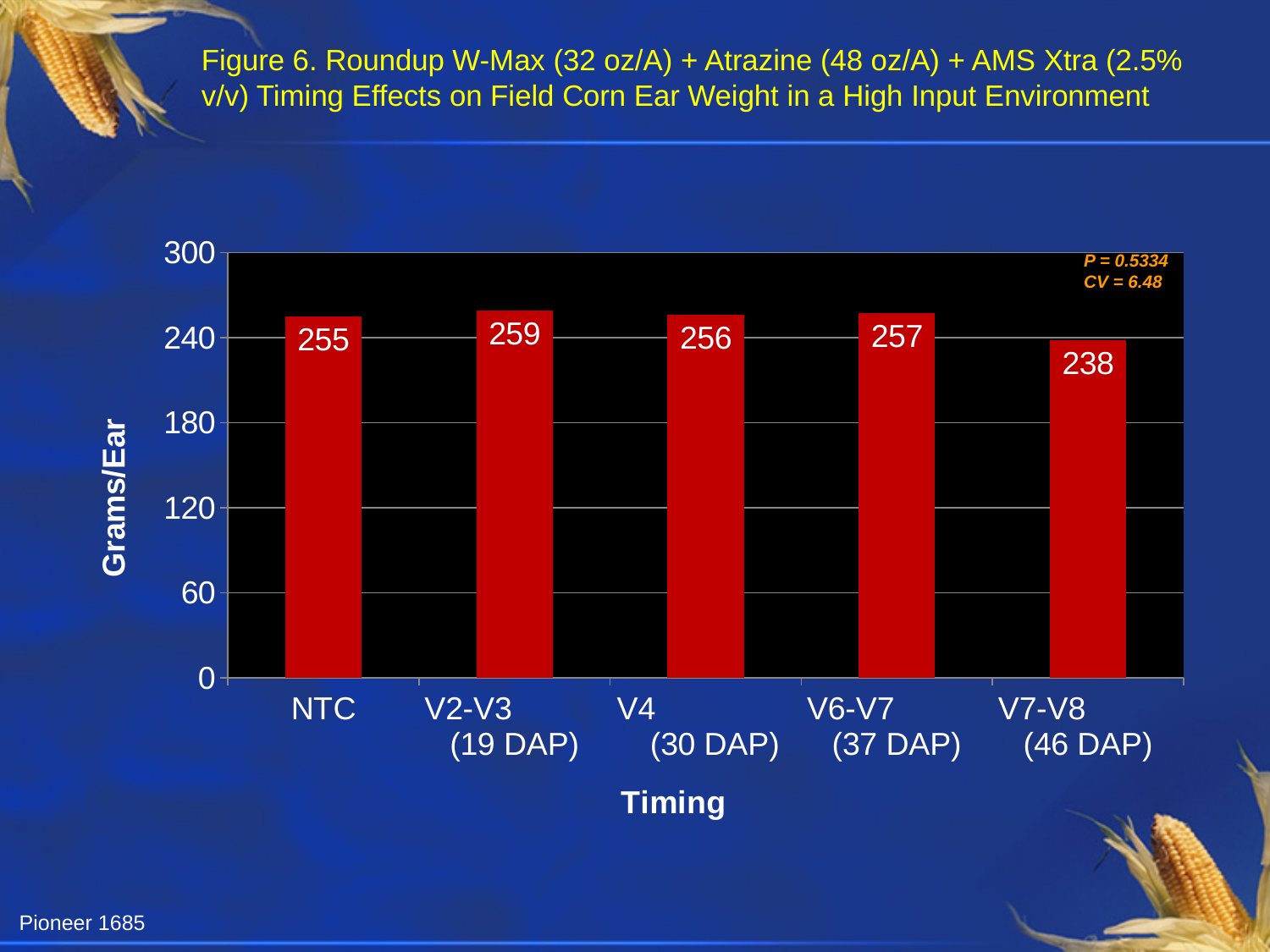
What is the difference in ear weight between the V2-V3 (19 DAP) timing and the V7-V8 (46 DAP) timing? 21 What kind of chart is shown on the slide? bar chart How many timing categories are shown on the x axis? 5 What is the ear weight value for the V7-V8 (46 DAP) timing? 238 Is the value for V7-V8 (46 DAP) greater or less than 240? less Which timing has the highest ear weight? V2-V3 (19 DAP) What is the ear weight value for the V2-V3 (19 DAP) timing? 259 Which has a larger ear weight, V6-V7 (37 DAP) or V7-V8 (46 DAP)? V6-V7 (37 DAP) Which timing has the lowest ear weight? V7-V8 (46 DAP) What is the label of the y axis? Grams/Ear What is the ear weight value for the NTC treatment? 255 What P value is printed on the chart? P = 0.5334